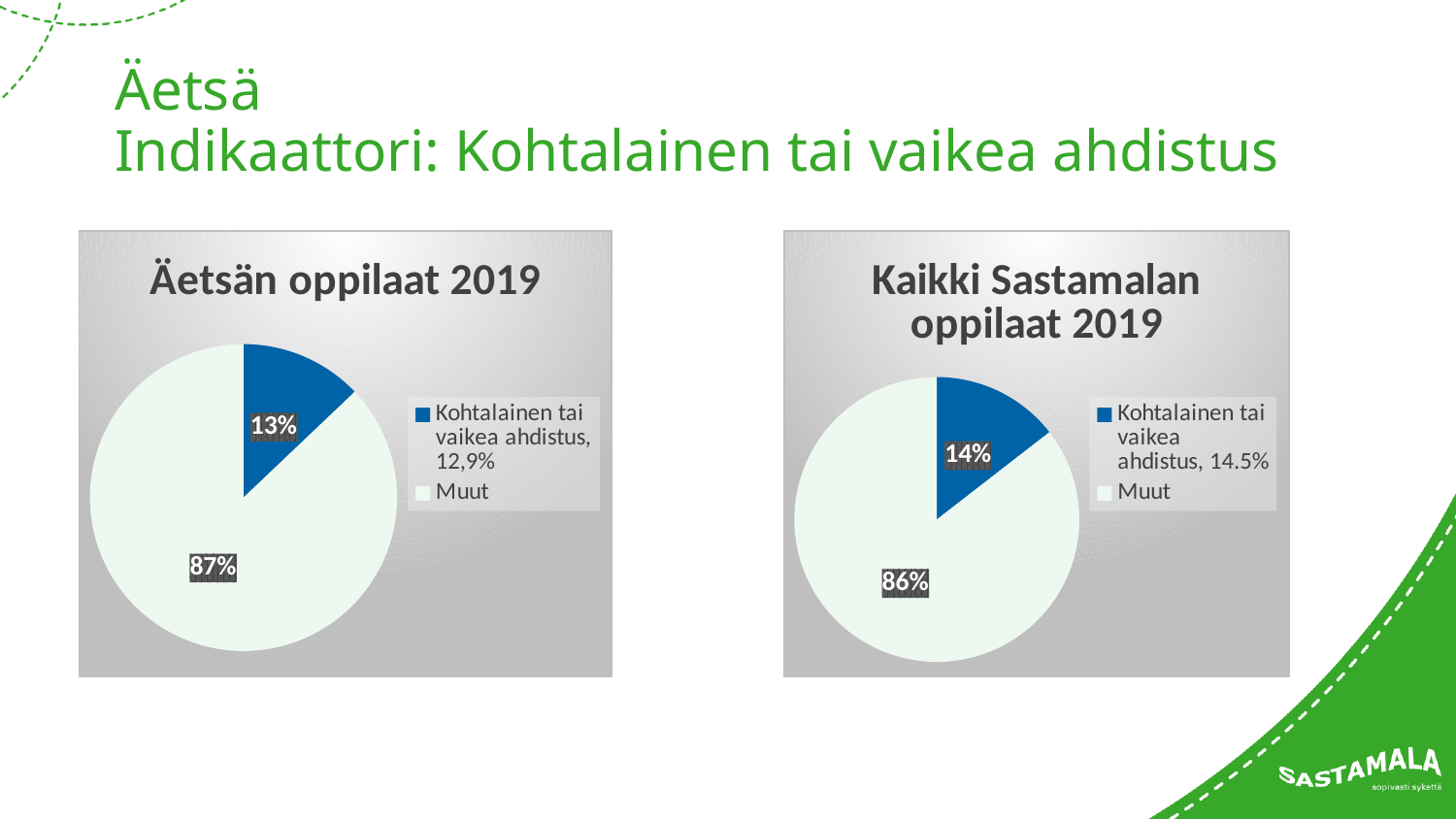
In the 'Kaikki Sastamalan oppilaat 2019' chart, what percentage is shown for the 'Kohtalainen tai vaikea ahdistus' slice? 14% In the 'Kaikki Sastamalan oppilaat 2019' chart, what value is given in the legend entry for 'Kohtalainen tai vaikea ahdistus'? 14.5% Which chart shows a larger share for 'Kohtalainen tai vaikea ahdistus', 'Äetsän oppilaat 2019' or 'Kaikki Sastamalan oppilaat 2019'? Kaikki Sastamalan oppilaat 2019 In the 'Äetsän oppilaat 2019' chart, what percentage is shown for the 'Kohtalainen tai vaikea ahdistus' slice? 13% In the 'Äetsän oppilaat 2019' chart, what colour is the 'Kohtalainen tai vaikea ahdistus' slice? Blue How many slices does the 'Kaikki Sastamalan oppilaat 2019' pie chart have? 2 In the 'Kaikki Sastamalan oppilaat 2019' chart, what percentage is shown for the 'Muut' slice? 86% In the 'Kaikki Sastamalan oppilaat 2019' chart, which slice is the smallest? Kohtalainen tai vaikea ahdistus In the 'Äetsän oppilaat 2019' chart, which slice is the largest? Muut What type of chart is 'Äetsän oppilaat 2019'? Pie chart In the 'Äetsän oppilaat 2019' chart, what is the difference in percentage points between the 'Muut' slice and the 'Kohtalainen tai vaikea ahdistus' slice? 74 In the 'Äetsän oppilaat 2019' chart, what percentage is shown for the 'Muut' slice? 87%